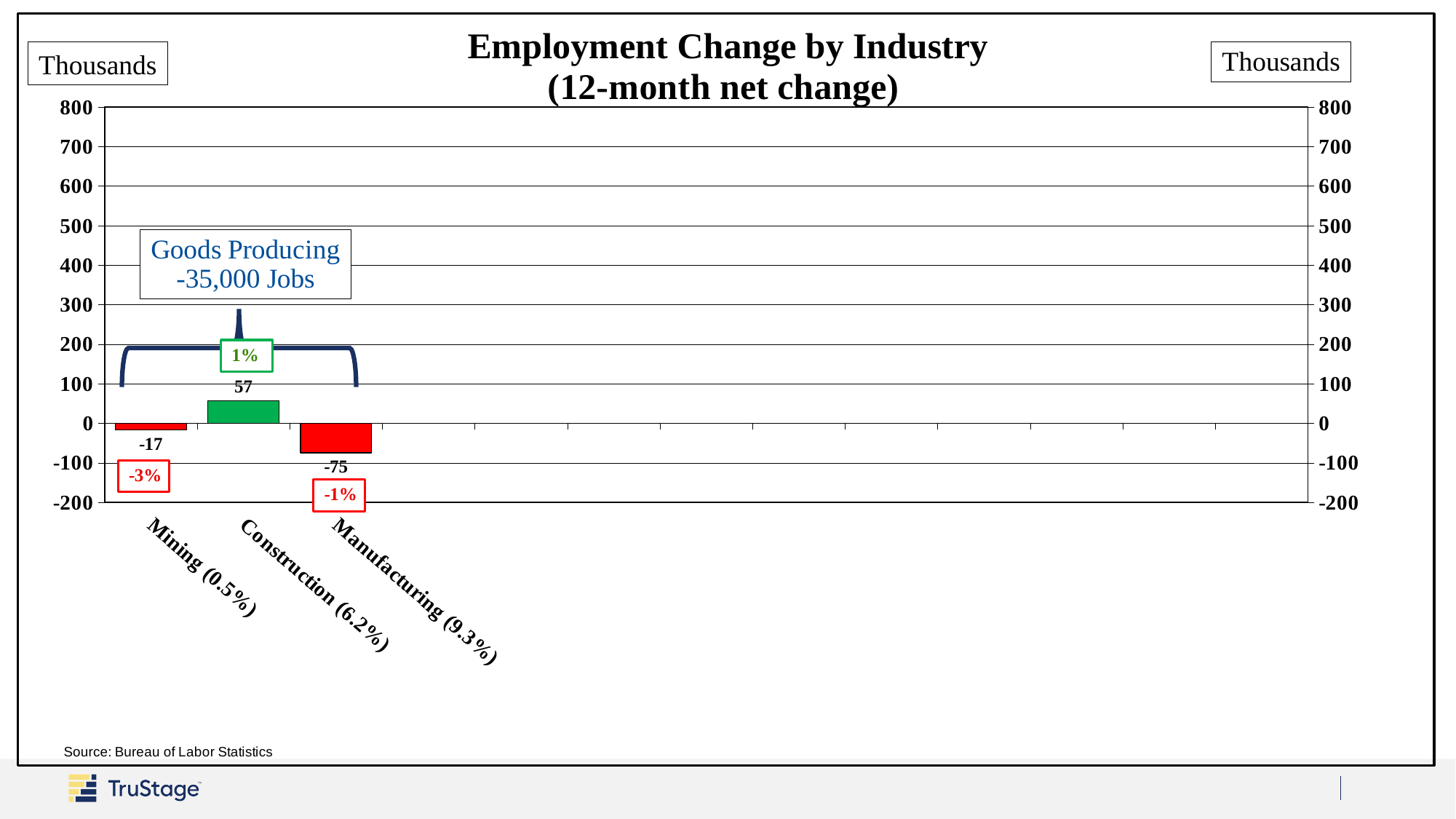
Is the value for Construction (6.2%) greater or less than 100? less What is the value for Construction (6.2%)? 57 What is the difference between the values for Construction (6.2%) and Manufacturing (9.3%)? 132 Which industry has the lowest employment change? Manufacturing (9.3%) What is the difference between the values for Mining (0.5%) and Manufacturing (9.3%)? 58 How many industries are plotted on the chart? 3 What is the value for Manufacturing (9.3%)? -75 What is the value for Mining (0.5%)? -17 What is the title of the chart? Employment Change by Industry (12-month net change) What kind of chart is shown on the slide? bar chart Which industry has the highest employment change? Construction (6.2%) Which is larger, the value for Mining (0.5%) or the value for Manufacturing (9.3%)? Mining (0.5%)